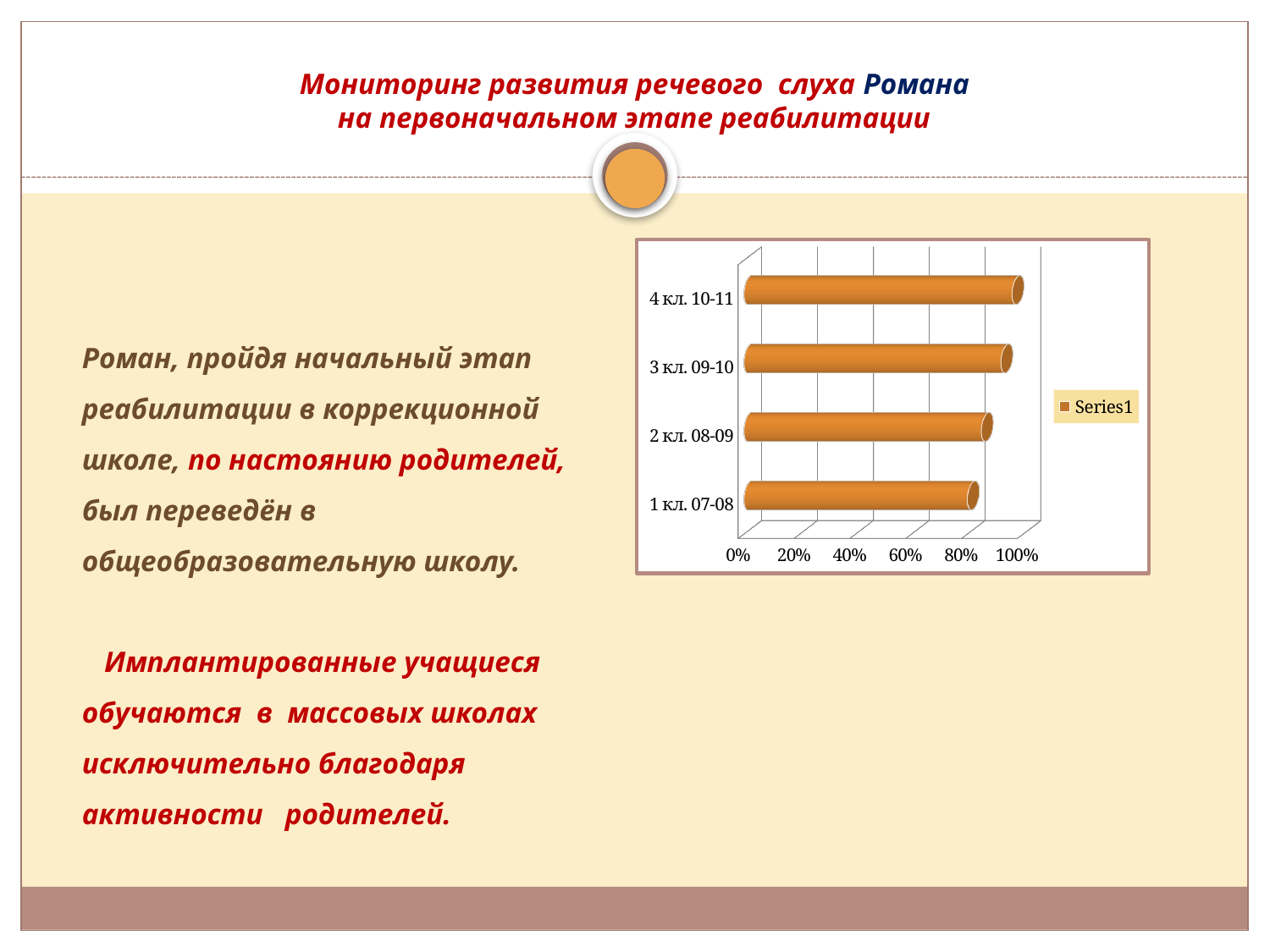
Do the values rise or fall from 1 кл. 07-08 to 4 кл. 10-11? rise Is the value for 1 кл. 07-08 greater or less than 60%? greater Which has the larger value, 1 кл. 07-08 or 4 кл. 10-11? 4 кл. 10-11 Which has the larger value, 2 кл. 08-09 or 3 кл. 09-10? 3 кл. 09-10 Which category has the highest value in the chart? 4 кл. 10-11 What kind of chart is shown on the slide? bar chart Which category has the lowest value in the chart? 1 кл. 07-08 How many categories are plotted in the chart? 4 Is the value for 4 кл. 10-11 greater or less than 80%? greater What is the name of the series shown in the chart legend? Series1 How many series does the chart legend list? 1 Is the value for 2 кл. 08-09 greater or less than 40%? greater